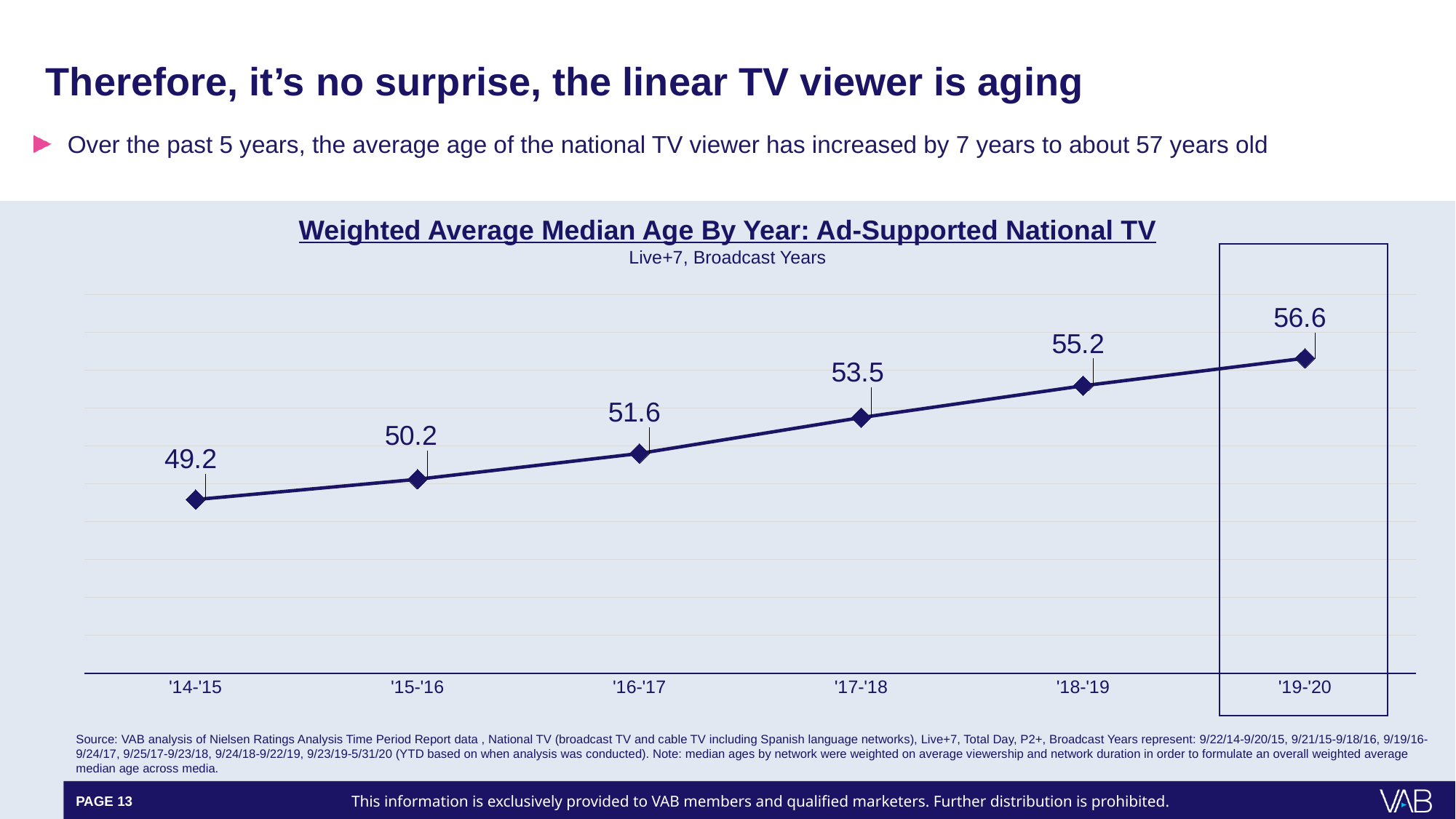
Which broadcast year has the lowest weighted average median age? '14-'15 What is the weighted average median age for '14-'15? 49.2 What is the difference in median age between '19-'20 and '14-'15? 7.4 What is the weighted average median age for '17-'18? 53.5 Which is larger, the median age for '16-'17 or for '15-'16? '16-'17 Do the median age values rise or fall from '14-'15 to '19-'20? Rise What is the weighted average median age for '19-'20? 56.6 Which broadcast year has the highest weighted average median age? '19-'20 What is the difference in median age between '18-'19 and '17-'18? 1.7 How many broadcast years are plotted on the chart? 6 What kind of chart is shown on the slide? Line chart What is the title of the chart? Weighted Average Median Age By Year: Ad-Supported National TV